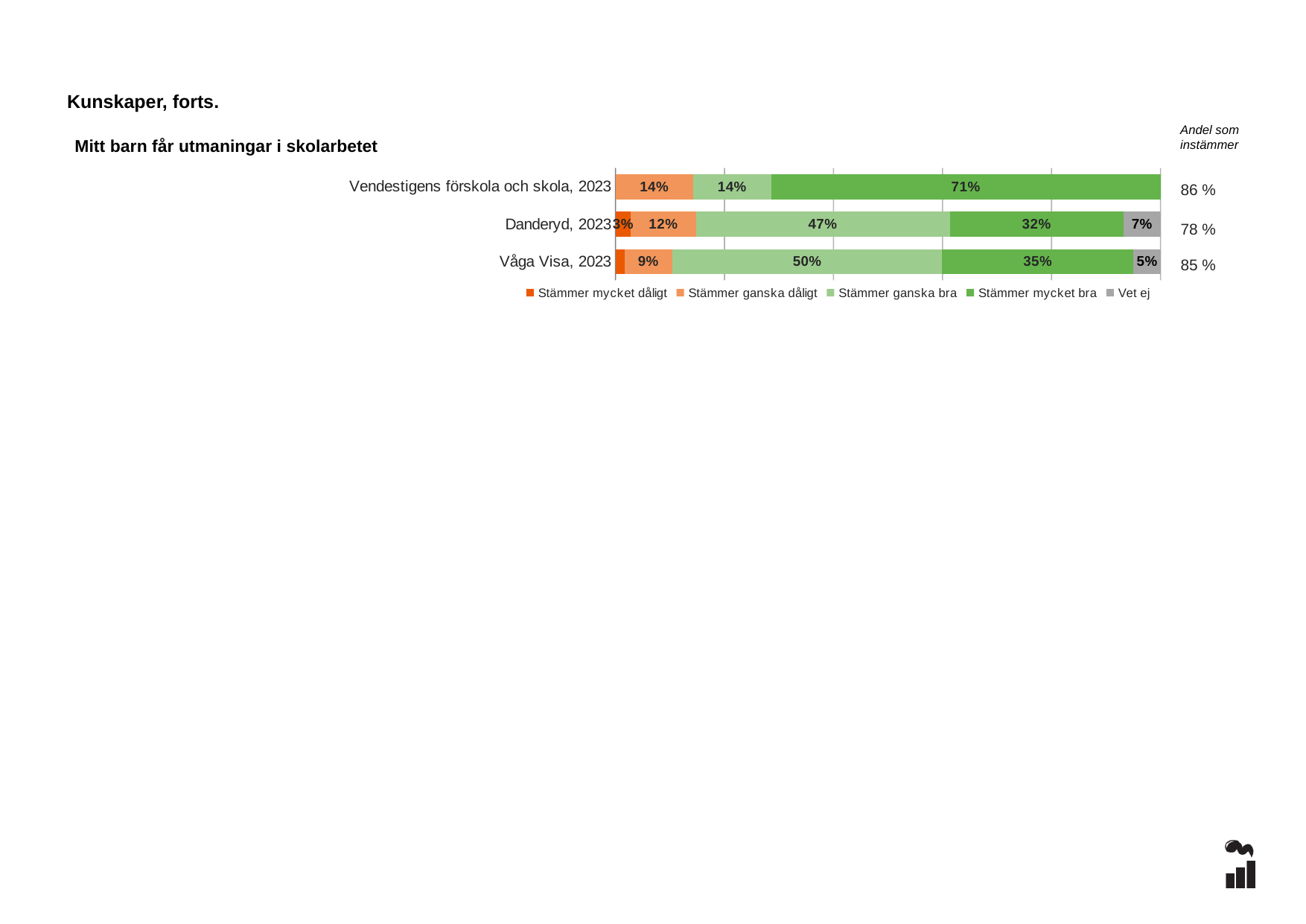
What is the 'Vet ej' value for Danderyd, 2023? 7% What is the 'Stämmer mycket bra' value for Vendestigens förskola och skola, 2023? 71% What type of chart is shown on the slide? Stacked bar chart How many series does the legend list? 5 Which category has the highest 'Stämmer mycket bra' value? Vendestigens förskola och skola, 2023 Which category has the lowest 'Stämmer ganska bra' value? Vendestigens förskola och skola, 2023 Which is larger: the 'Stämmer ganska dåligt' value for Danderyd, 2023 or for Våga Visa, 2023? Danderyd, 2023 What is the 'Stämmer ganska bra' value for Danderyd, 2023? 47% How many categories (bars) are shown in the chart? 3 What is the 'Stämmer ganska dåligt' value for Våga Visa, 2023? 9% What is the 'Andel som instämmer' figure shown for Danderyd, 2023? 78 % What is the difference between the 'Stämmer mycket bra' values for Våga Visa, 2023 and Danderyd, 2023? 3%